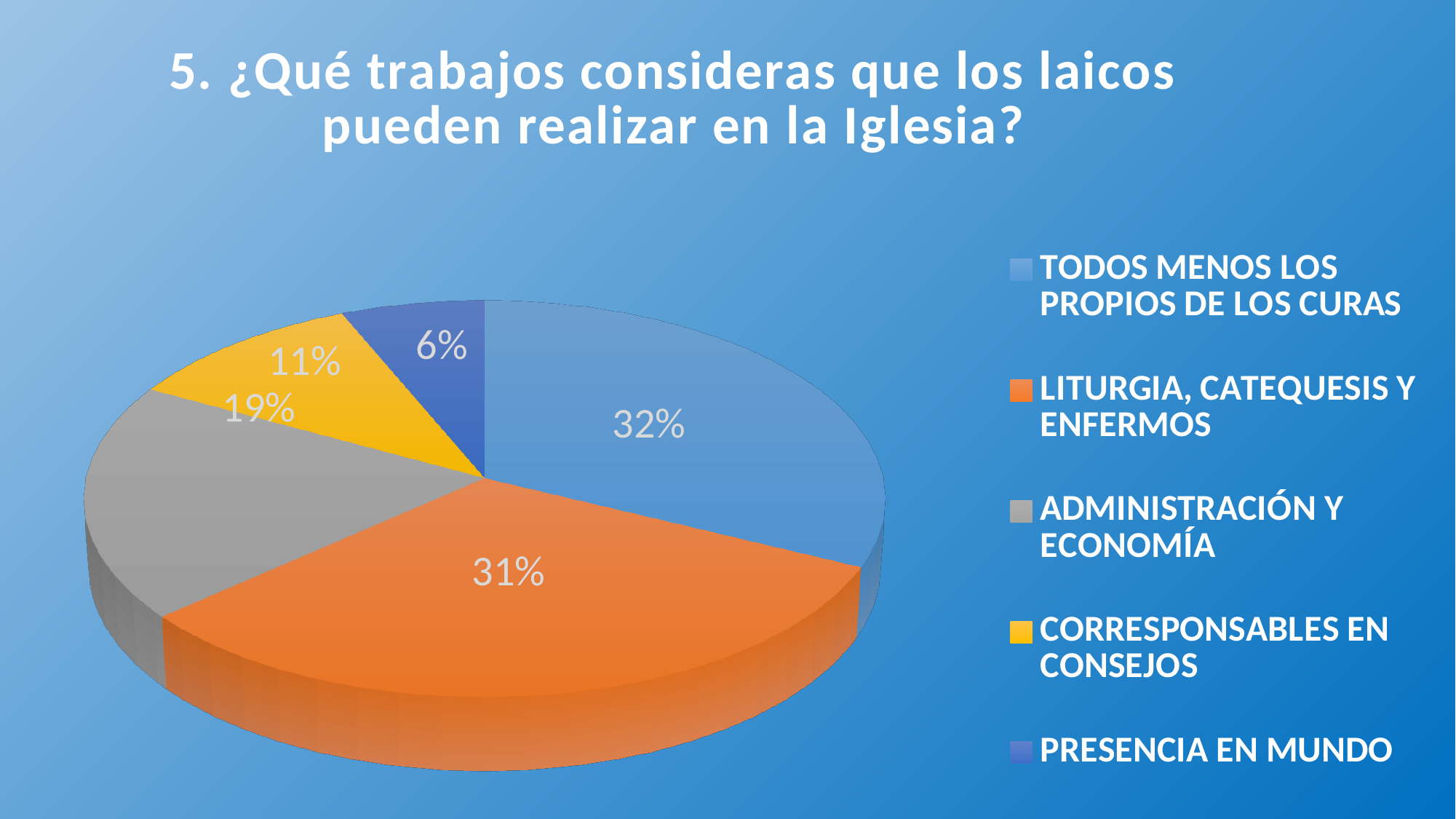
Which category has the smallest share of the pie? PRESENCIA EN MUNDO What type of chart is shown on the slide? pie chart What percentage of the pie corresponds to LITURGIA, CATEQUESIS Y ENFERMOS? 31% What percentage of the pie corresponds to PRESENCIA EN MUNDO? 6% What percentage of the pie corresponds to TODOS MENOS LOS PROPIOS DE LOS CURAS? 32% Which category has the largest share of the pie? TODOS MENOS LOS PROPIOS DE LOS CURAS What colour is the slice for CORRESPONSABLES EN CONSEJOS? yellow What percentage of the pie corresponds to ADMINISTRACIÓN Y ECONOMÍA? 19% Which is larger: the share for ADMINISTRACIÓN Y ECONOMÍA or the share for PRESENCIA EN MUNDO? ADMINISTRACIÓN Y ECONOMÍA How many categories does the pie chart have? 5 What is the difference in percentage points between ADMINISTRACIÓN Y ECONOMÍA and CORRESPONSABLES EN CONSEJOS? 8 What percentage of the pie corresponds to CORRESPONSABLES EN CONSEJOS? 11%